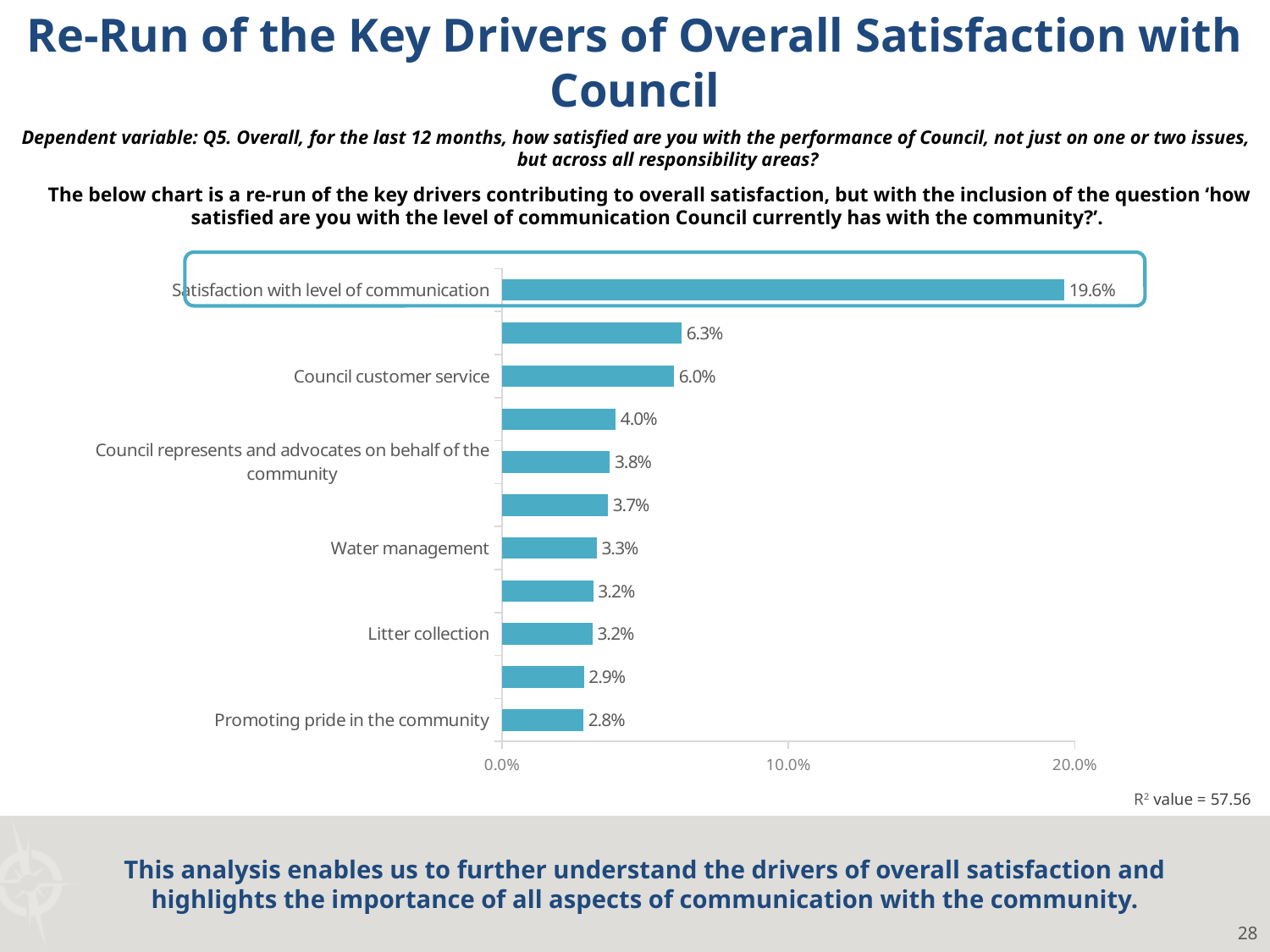
What kind of chart is shown on the slide? Bar chart How many bars are plotted in the chart? 11 What is the value for Promoting pride in the community? 2.8% What is the value for Water management? 3.3% What is the value for Council customer service? 6.0% Which category has the lowest value? Promoting pride in the community What is the value for Satisfaction with level of communication? 19.6% Which category has the highest value? Satisfaction with level of communication What is the value for Council represents and advocates on behalf of the community? 3.8% Which is larger, the value for Water management or the value for Promoting pride in the community? Water management What is the difference between the values for Satisfaction with level of communication and Council customer service? 13.6% What is the value for Litter collection? 3.2%